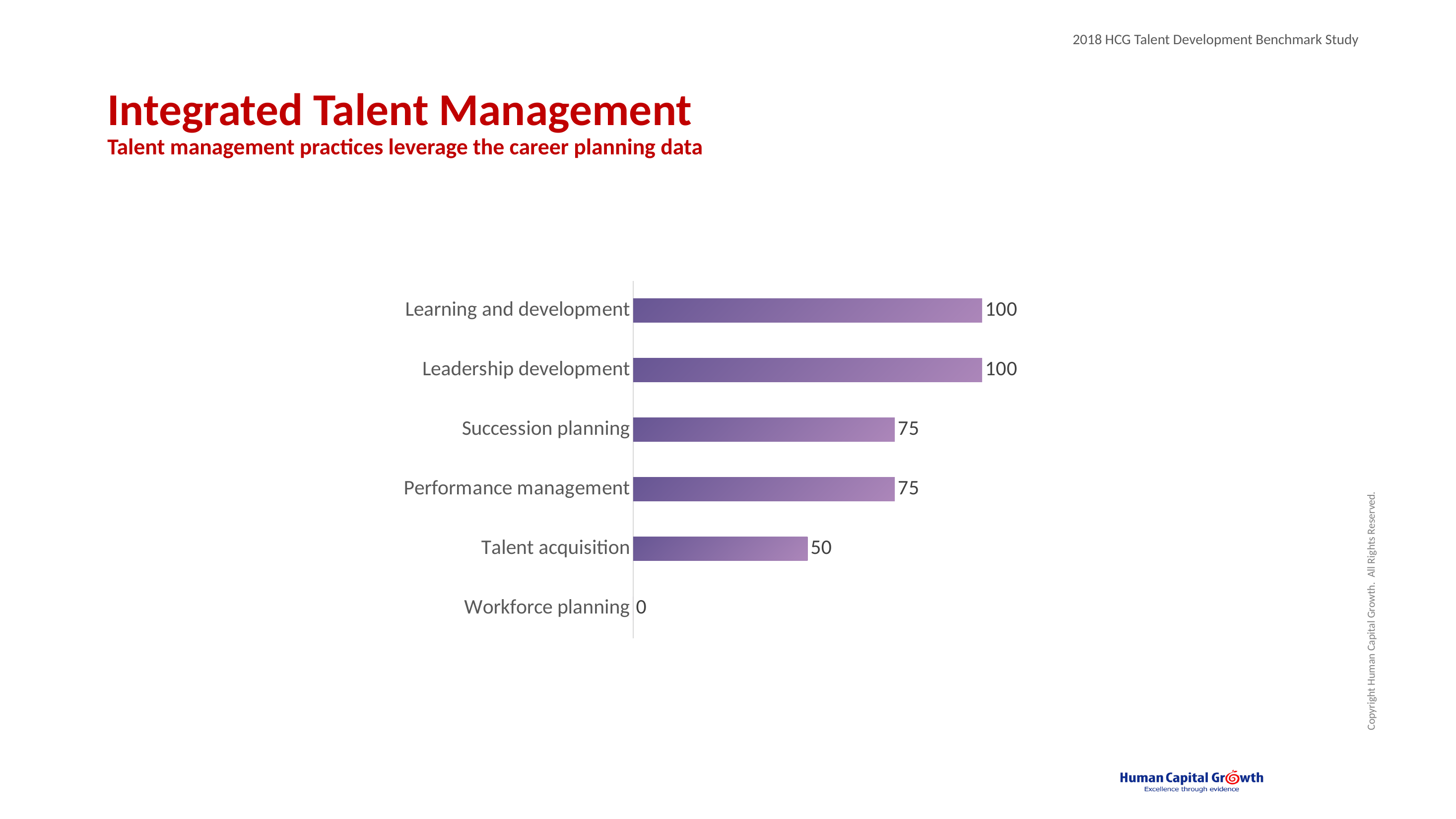
What is the title of the slide containing the chart? Integrated Talent Management What is the value for Succession planning? 75 What is the value for Talent acquisition? 50 How many categories have a value of 100? 2 What is the difference between the values for Performance management and Talent acquisition? 25 Which is larger, the value for Succession planning or the value for Talent acquisition? Succession planning What is the value for Workforce planning? 0 How many categories are shown in the chart? 6 What is the value for Leadership development? 100 What kind of chart is shown on the slide? Bar chart What is the difference between the values for Learning and development and Talent acquisition? 50 Which category has the lowest value? Workforce planning